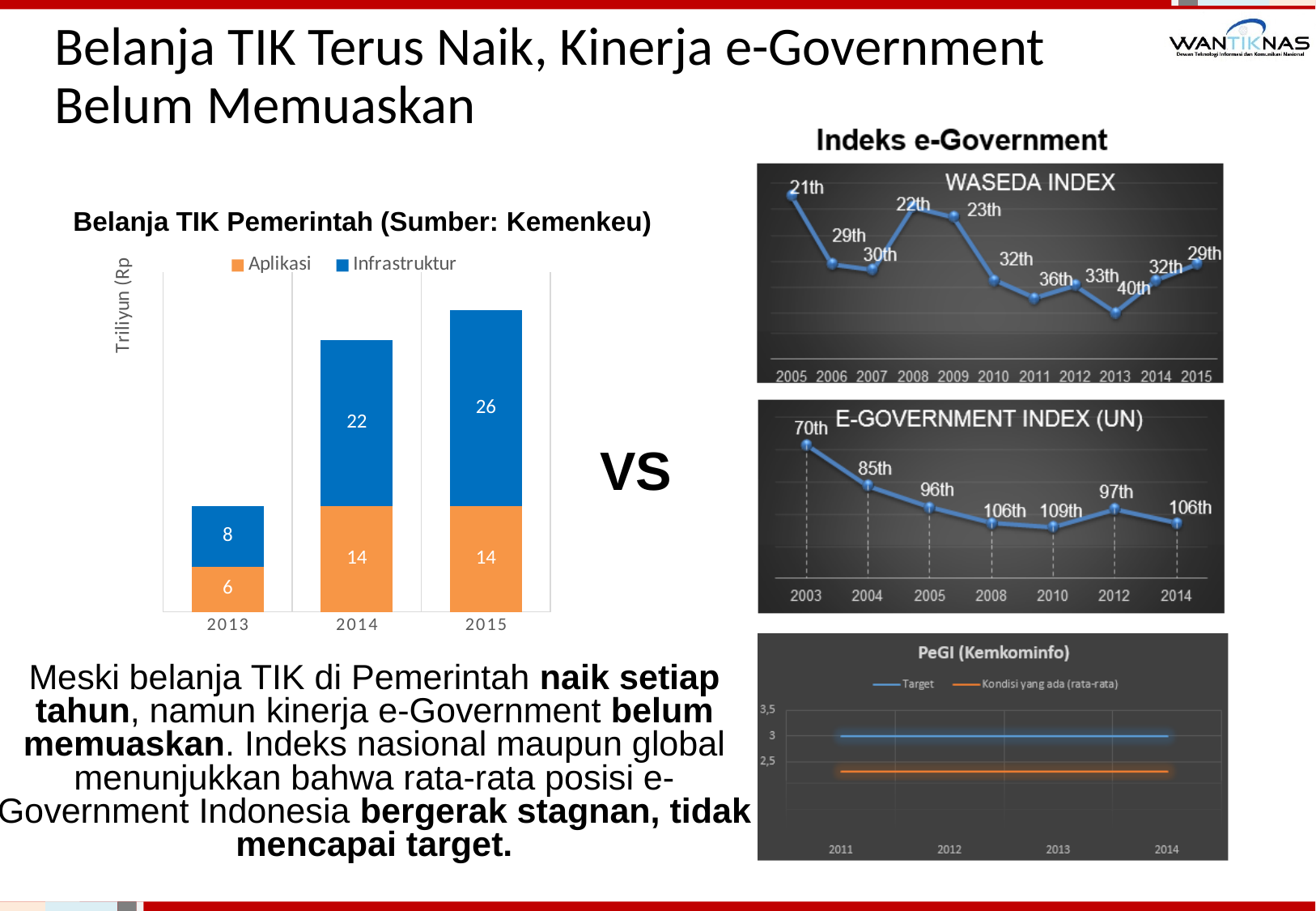
In the WASEDA INDEX chart, what is the value for 2013? 40th In the E-GOVERNMENT INDEX (UN) chart, which year has the lowest-numbered rank? 2003 In the E-GOVERNMENT INDEX (UN) chart, what is the value for 2010? 109th In the WASEDA INDEX chart, how many years are plotted? 11 In the Belanja TIK Pemerintah chart, what is the Aplikasi value for 2013? 6 In the Belanja TIK Pemerintah chart, what is the difference between the Infrastruktur values for 2015 and 2013? 18 In the PeGI (Kemkominfo) chart, what is the value of the Target line? 3 In the Belanja TIK Pemerintah chart, how many series does the legend list? 2 In the PeGI (Kemkominfo) chart, is the value of Kondisi yang ada (rata-rata) greater or less than 2,5? less In the Belanja TIK Pemerintah chart, what is the total of the stacked bar for 2014? 36 In the Belanja TIK Pemerintah chart, what is the Infrastruktur value for 2015? 26 What kind of chart is the Belanja TIK Pemerintah chart? Stacked bar chart